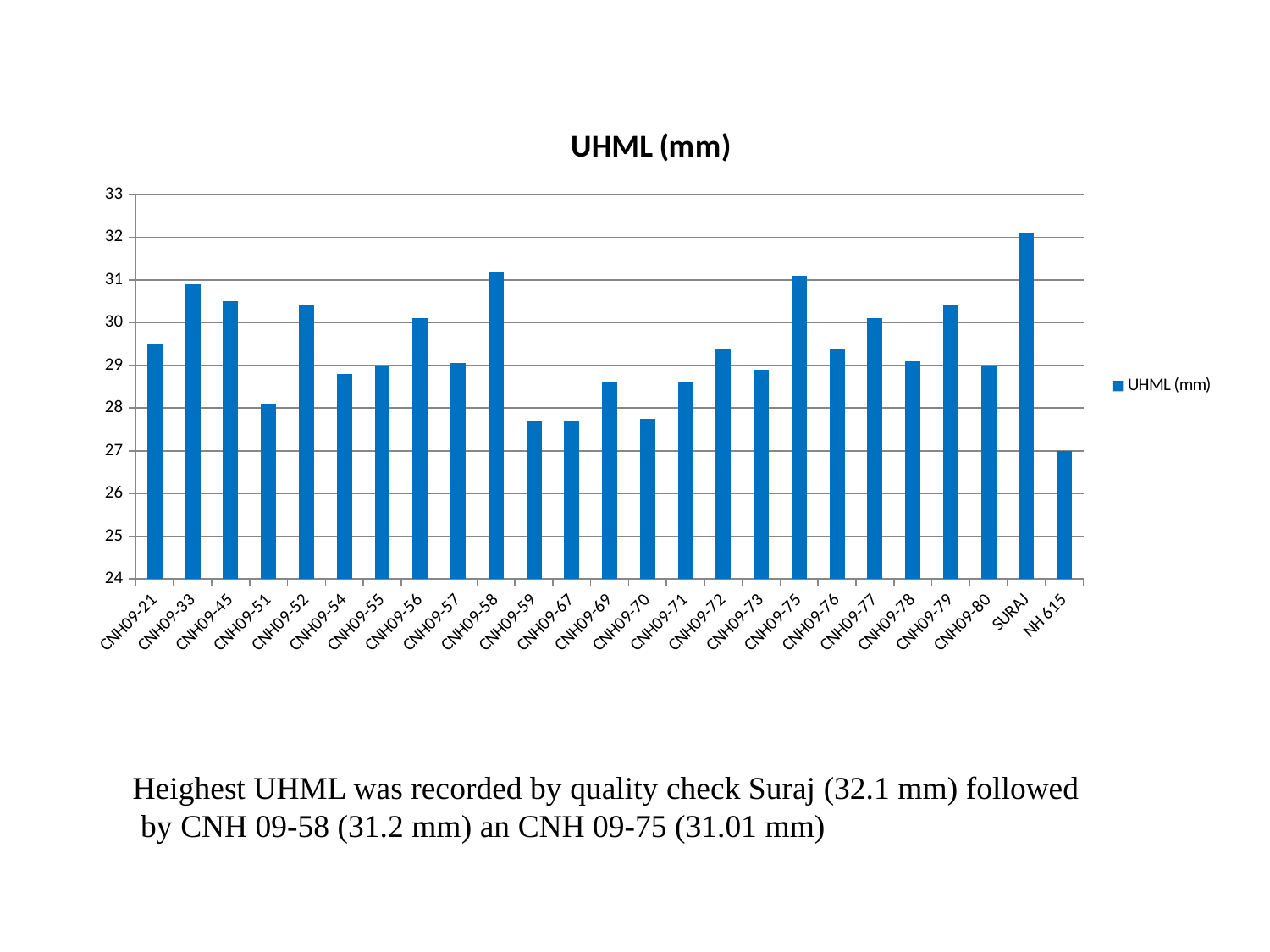
Which has the larger UHML value, CNH09-52 or CNH09-54? CNH09-52 How many categories are plotted along the x axis? 25 Which category has the lowest UHML value? NH 615 Is the value for NH 615 greater or less than 28? less What is the title of the chart? UHML (mm) What UHML value was recorded for Suraj, according to the slide? 32.1 mm What kind of chart is shown on the slide? bar chart Which category has the highest UHML value? SURAJ Is the value for CNH09-21 greater or less than 29? greater Is the value for CNH09-58 greater or less than 31? greater How many series does the legend list? 1